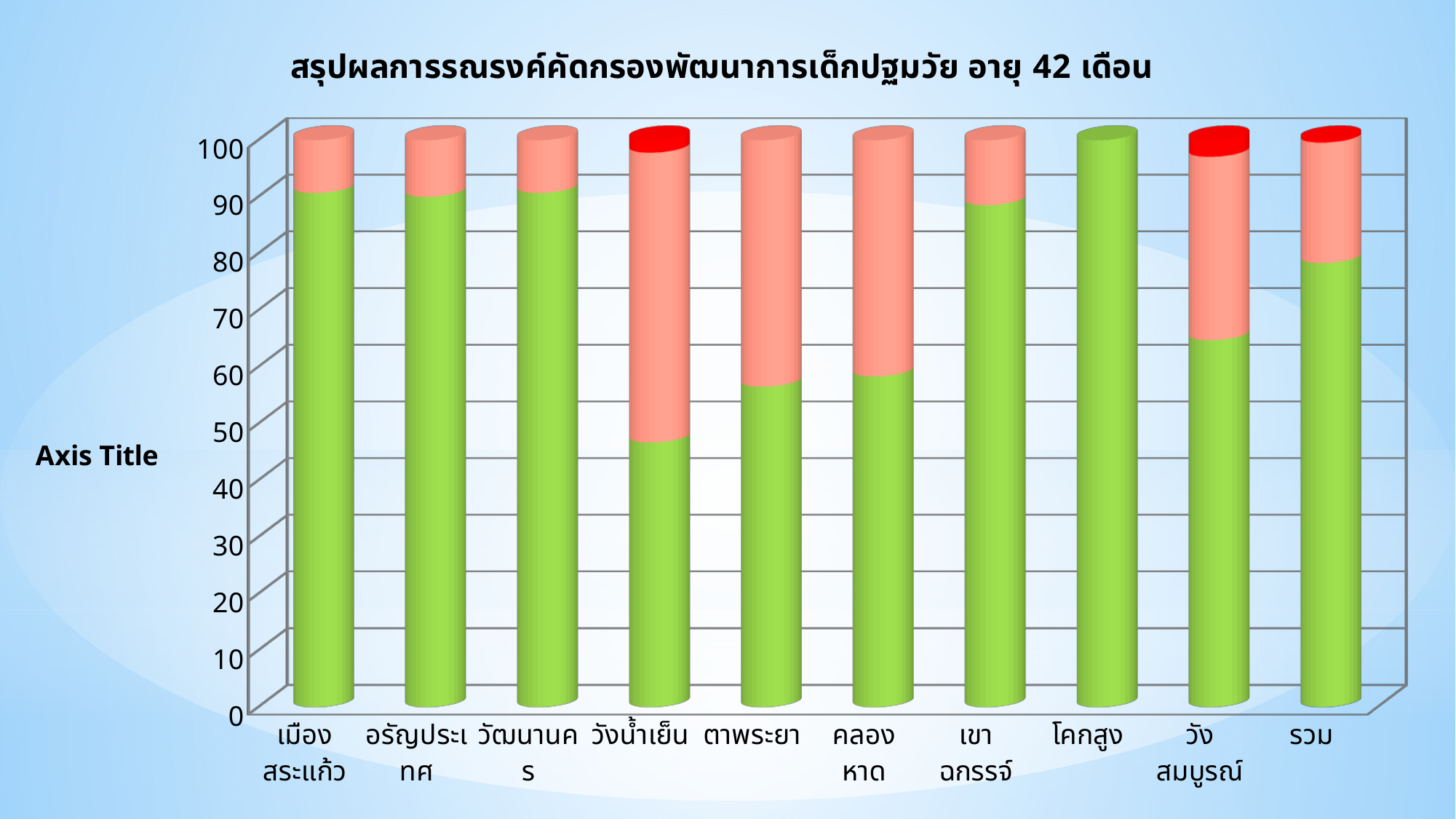
How many categories are shown along the x axis? 10 Which category has the tallest green segment? โคกสูง Is the green segment for รวม greater or less than 70? greater What text is shown as the vertical axis title? Axis Title Is the green segment for เขาฉกรรจ์ greater or less than 80? greater Is the green segment for วังสมบูรณ์ greater or less than 60? greater Which has the larger green segment, ตาพระยา or วังสมบูรณ์? วังสมบูรณ์ Which category has the shortest green segment? วังน้ำเย็น What is the title of the chart? สรุปผลการรณรงค์คัดกรองพัฒนาการเด็กปฐมวัย อายุ 42 เดือน What kind of chart is shown on the slide? stacked bar chart